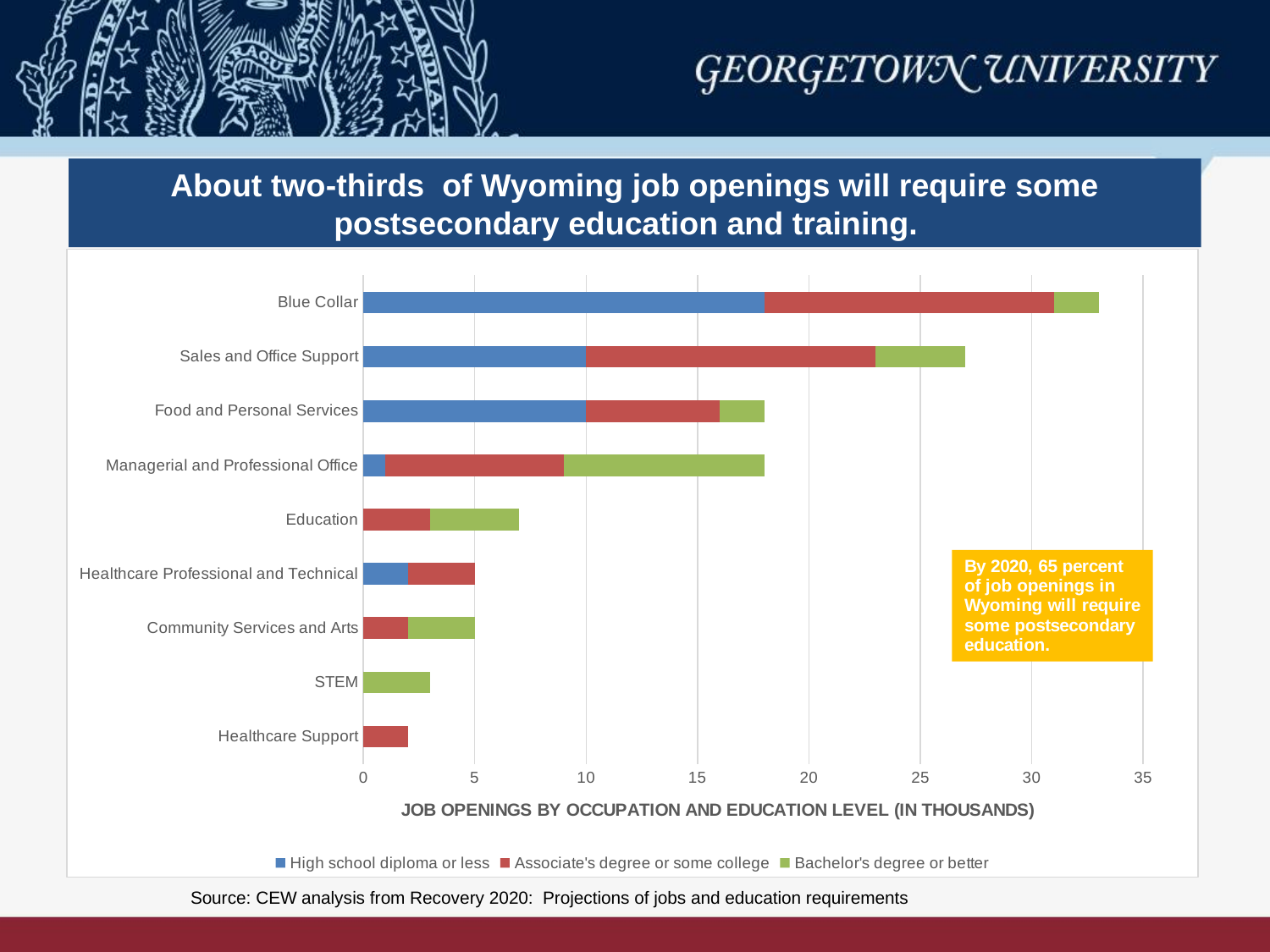
How many occupation categories are shown on the chart? 9 Is the total value for Sales and Office Support greater or less than 25? greater What kind of chart is shown on the slide? Stacked bar chart Is the total value for Healthcare Support greater or less than 5? less Is the total value for Managerial and Professional Office greater or less than 20? less Which has more total job openings, Blue Collar or Sales and Office Support? Blue Collar How many series does the legend list? 3 Which occupation has more total job openings, Education or STEM? Education Which occupation has the largest total number of job openings? Blue Collar What is the x-axis title of the chart? JOB OPENINGS BY OCCUPATION AND EDUCATION LEVEL (IN THOUSANDS)